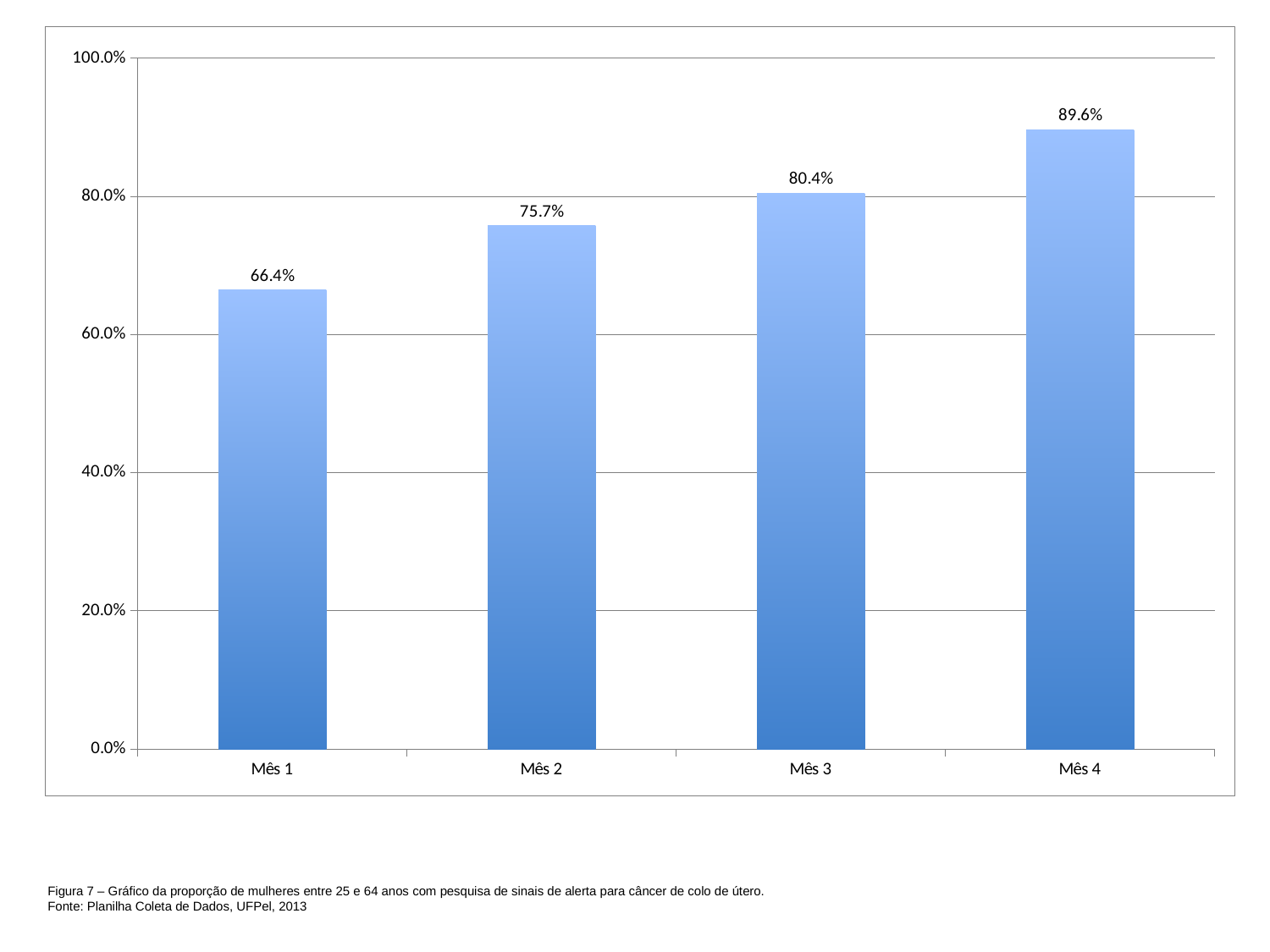
What is the value for Mês 4? 89.6% Do the values rise or fall from Mês 1 to Mês 4? rise Which month has the highest value? Mês 4 How many categories are shown on the x axis? 4 Is the value for Mês 2 greater or less than 80.0%? less Which is larger, the value for Mês 2 or the value for Mês 3? Mês 3 What is the value for Mês 1? 66.4% What is the value for Mês 3? 80.4% What is the difference between the values for Mês 4 and Mês 1? 23.2% What kind of chart is shown on the slide? bar chart Which month has the lowest value? Mês 1 What is the difference between the values for Mês 2 and Mês 1? 9.3%